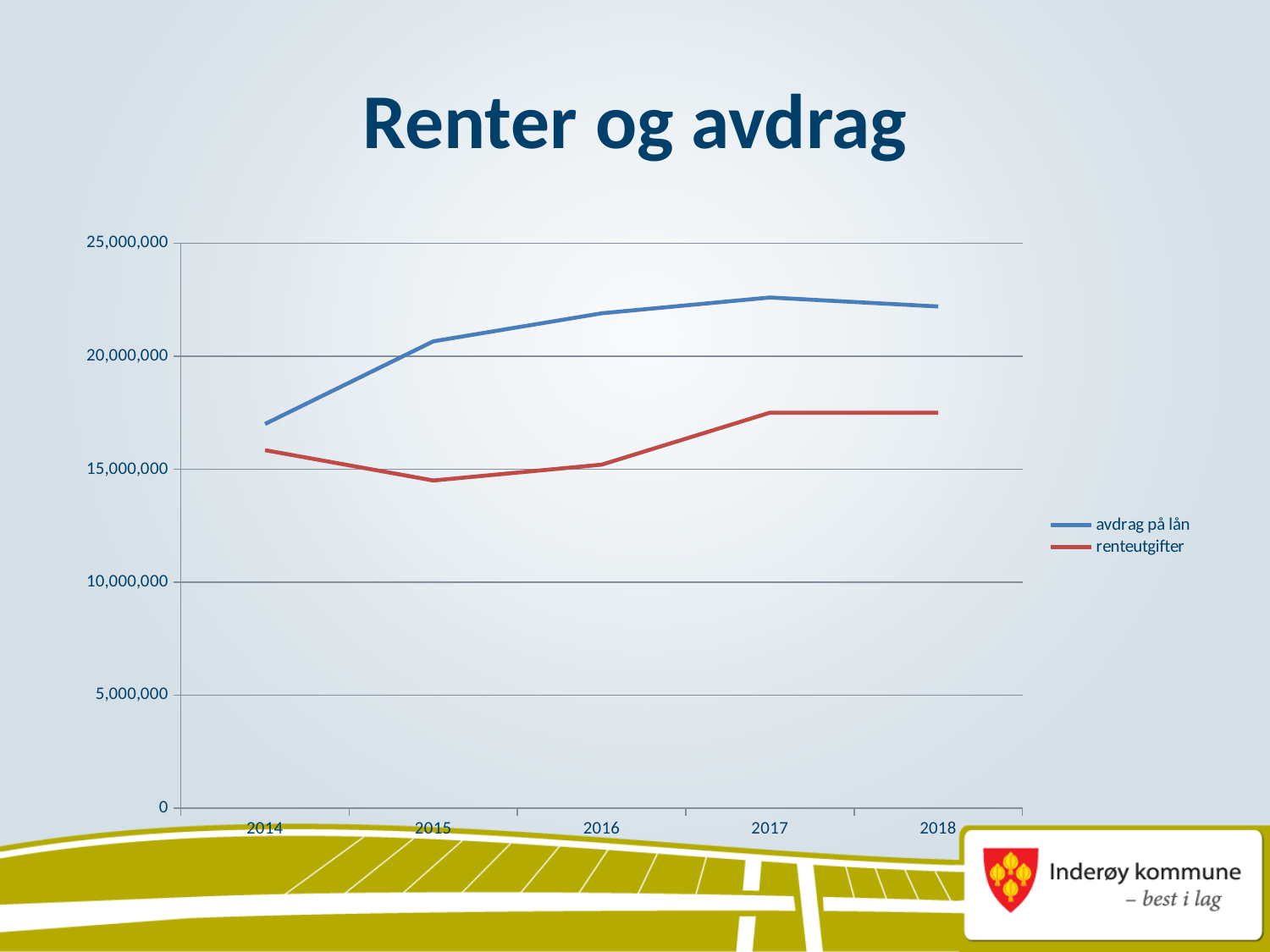
What kind of chart is shown on the slide? line chart Is the value for renteutgifter in 2015 greater or less than 15,000,000? less Is the value for avdrag på lån in 2015 greater or less than 20,000,000? greater How many years are shown on the x axis? 5 In which year is the value for avdrag på lån lowest? 2014 In which year is the value for avdrag på lån highest? 2017 How many series does the legend list? 2 Does the value for avdrag på lån rise or fall from 2014 to 2017? rise In which year is the value for renteutgifter lowest? 2015 Which series has the larger value in 2016, avdrag på lån or renteutgifter? avdrag på lån What is the title of the chart? Renter og avdrag Which series is drawn in red? renteutgifter